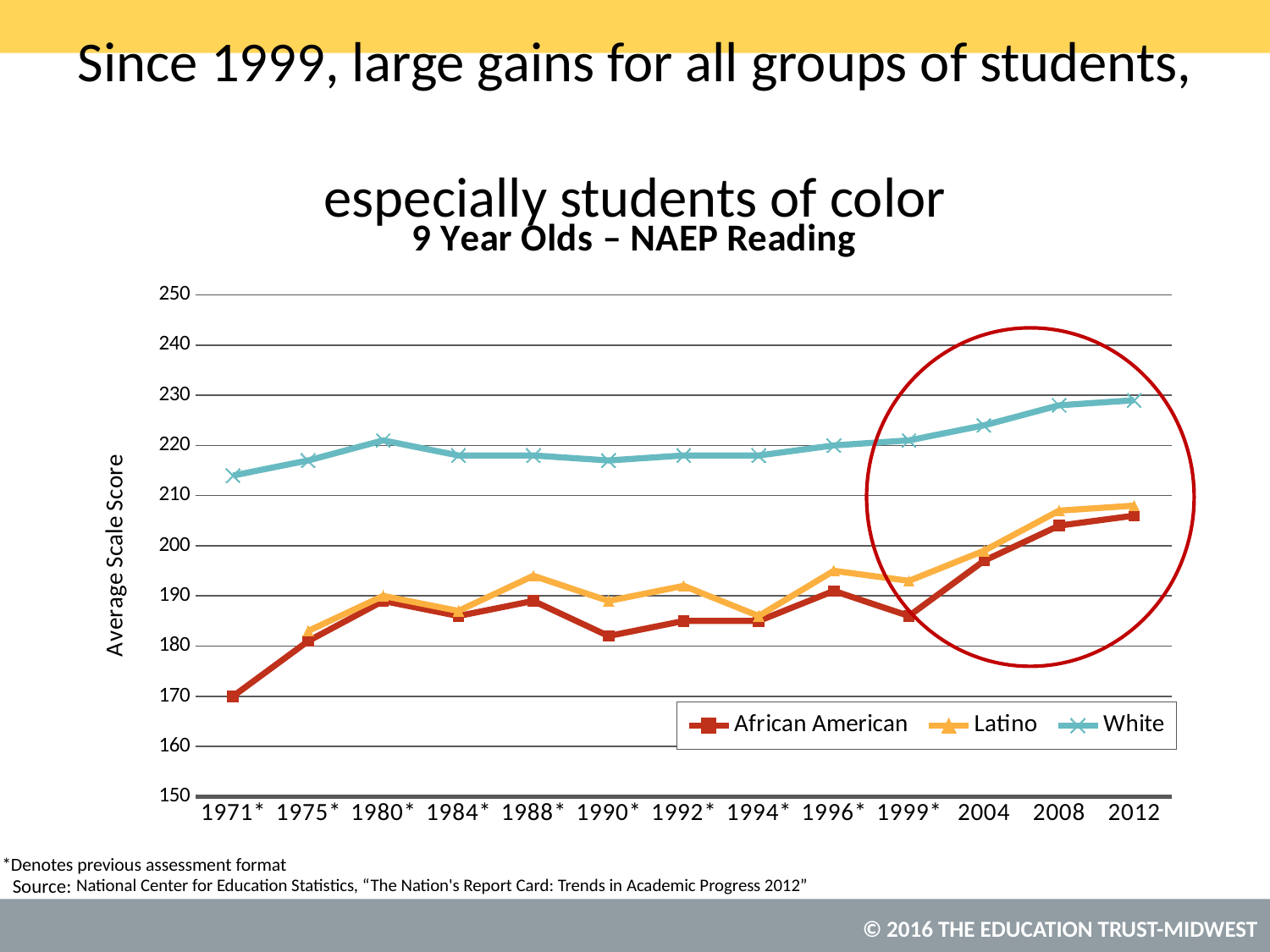
How many years are shown along the x axis of the chart? 13 Is the African American score in 1990* greater or less than 190? less How many series does the chart legend list? 3 Is the White score in 2012 greater or less than 220? greater What is the label on the vertical axis of the chart? Average Scale Score Which is larger in 1988*, the Latino score or the African American score? Latino Does the White score rise or fall from 1999* to 2012? Rises Is the White score in 1971* greater or less than 210? greater What type of chart is shown on the slide? Line chart In which year is the African American score at its lowest? 1971* Which group has the highest average scale score in 2012? White